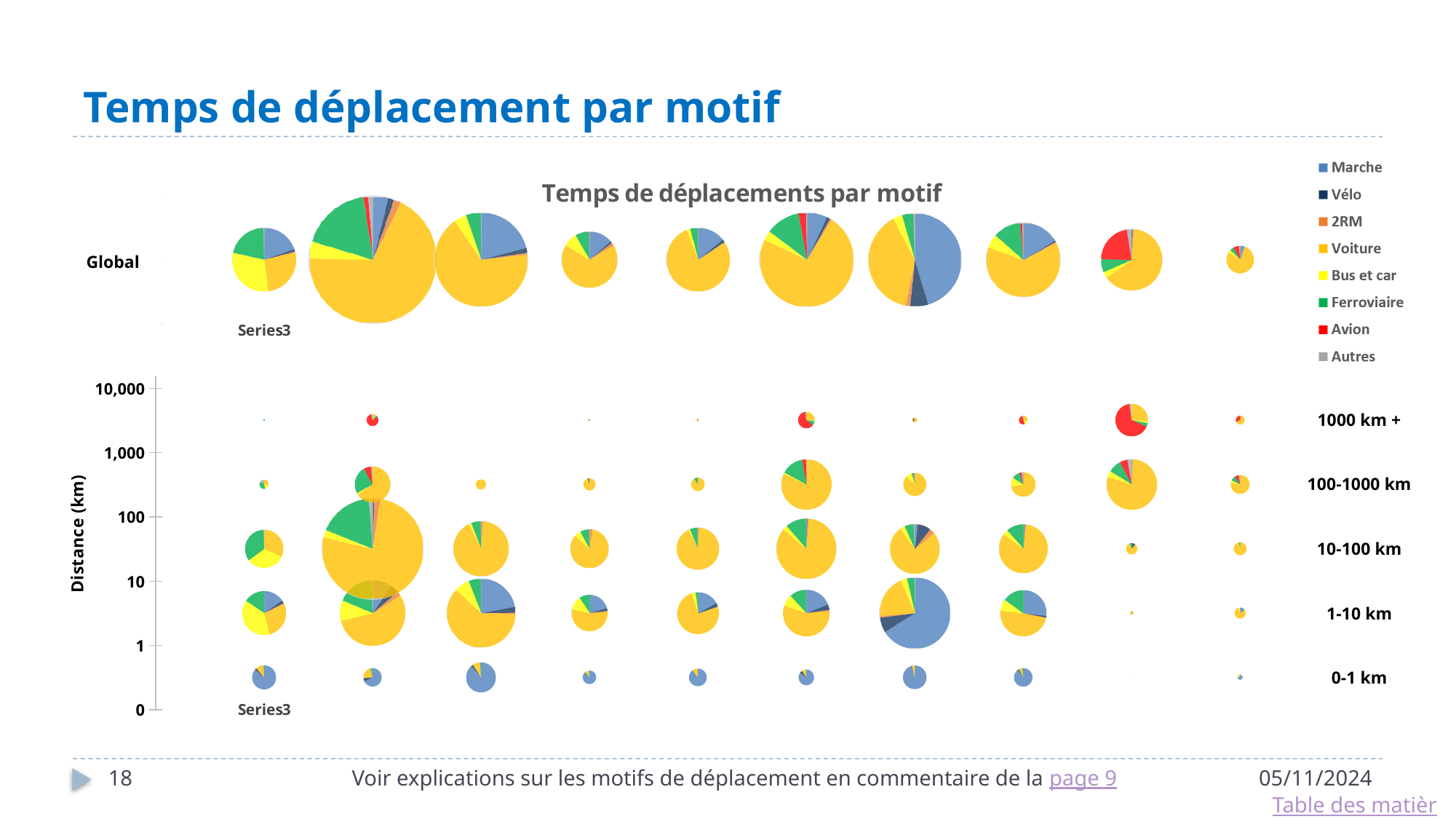
How many pie charts are shown in the Global row? 10 What is the title of the chart? Temps de déplacements par motif Which distance band label is placed highest on the chart? 1000 km + Which transport mode takes the largest share of the pies in the 0-1 km row? Marche Which transport mode takes the largest share of the pies in the 10-100 km row? Voiture Which distance band label is placed lowest on the chart? 0-1 km How many distance bands are labelled on the right side of the chart? 5 Which transport mode takes the largest share of most pies in the Global row? Voiture What kind of chart is used to show the modal split in each cell of the grid? Pie chart What is the label of the vertical axis? Distance (km) How many entries does the legend list? 8